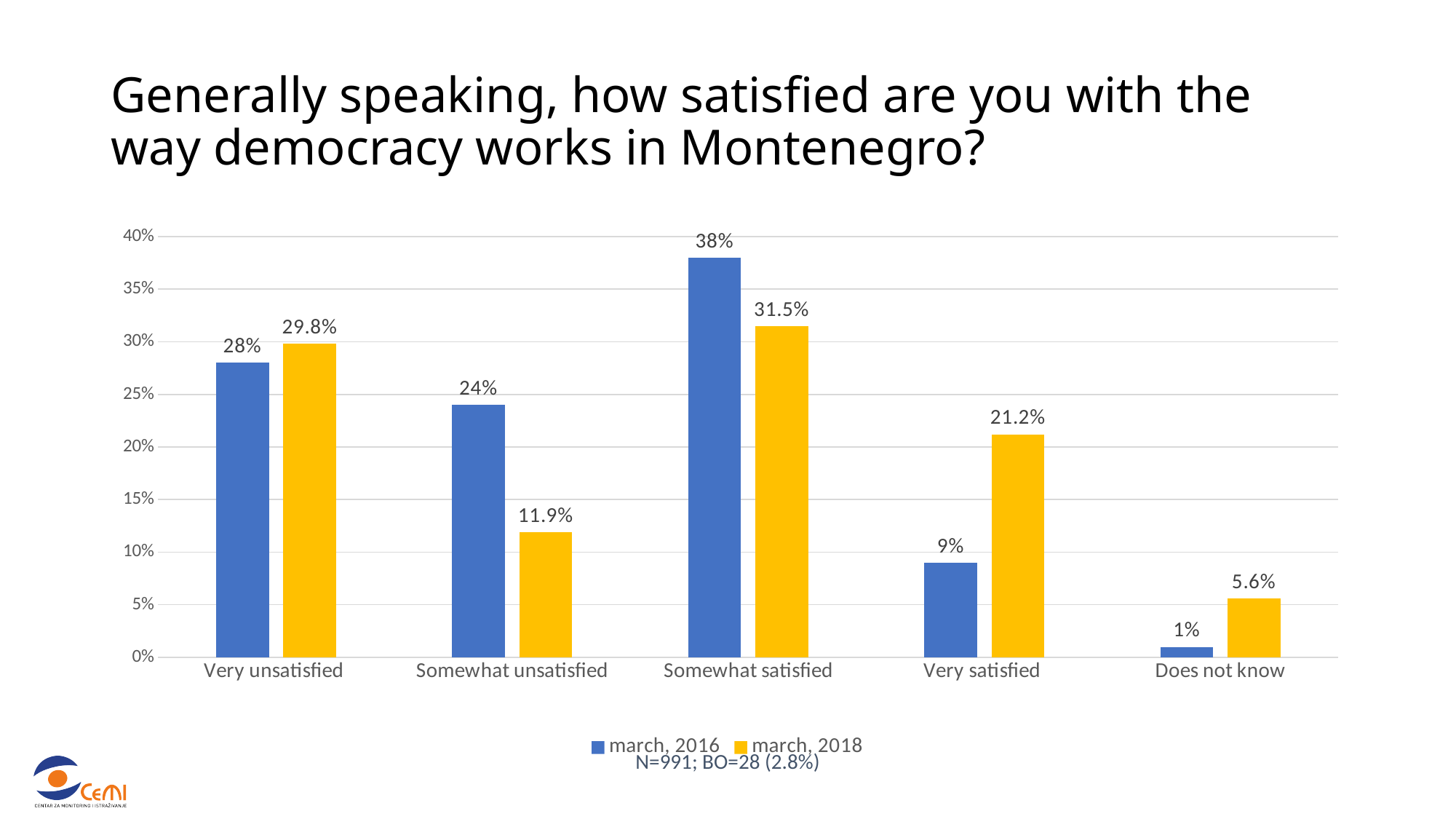
Which category has the lowest value in the march, 2016 series? Does not know What is the value for Does not know in the march, 2016 series? 1% How many series does the legend list? 2 Which colour represents the march, 2018 series? Yellow Which is larger for Very unsatisfied: the march, 2016 value or the march, 2018 value? march, 2018 Which category has the highest value in the march, 2018 series? Somewhat satisfied What is the value for Very satisfied in the march, 2018 series? 21.2% How many categories are shown on the x axis? 5 Is the march, 2018 value for Somewhat satisfied greater or less than 30%? greater What is the difference between the march, 2016 and march, 2018 values for Somewhat unsatisfied? 12.1% What is the value for Somewhat satisfied in the march, 2016 series? 38% What kind of chart is shown on the slide? Bar chart